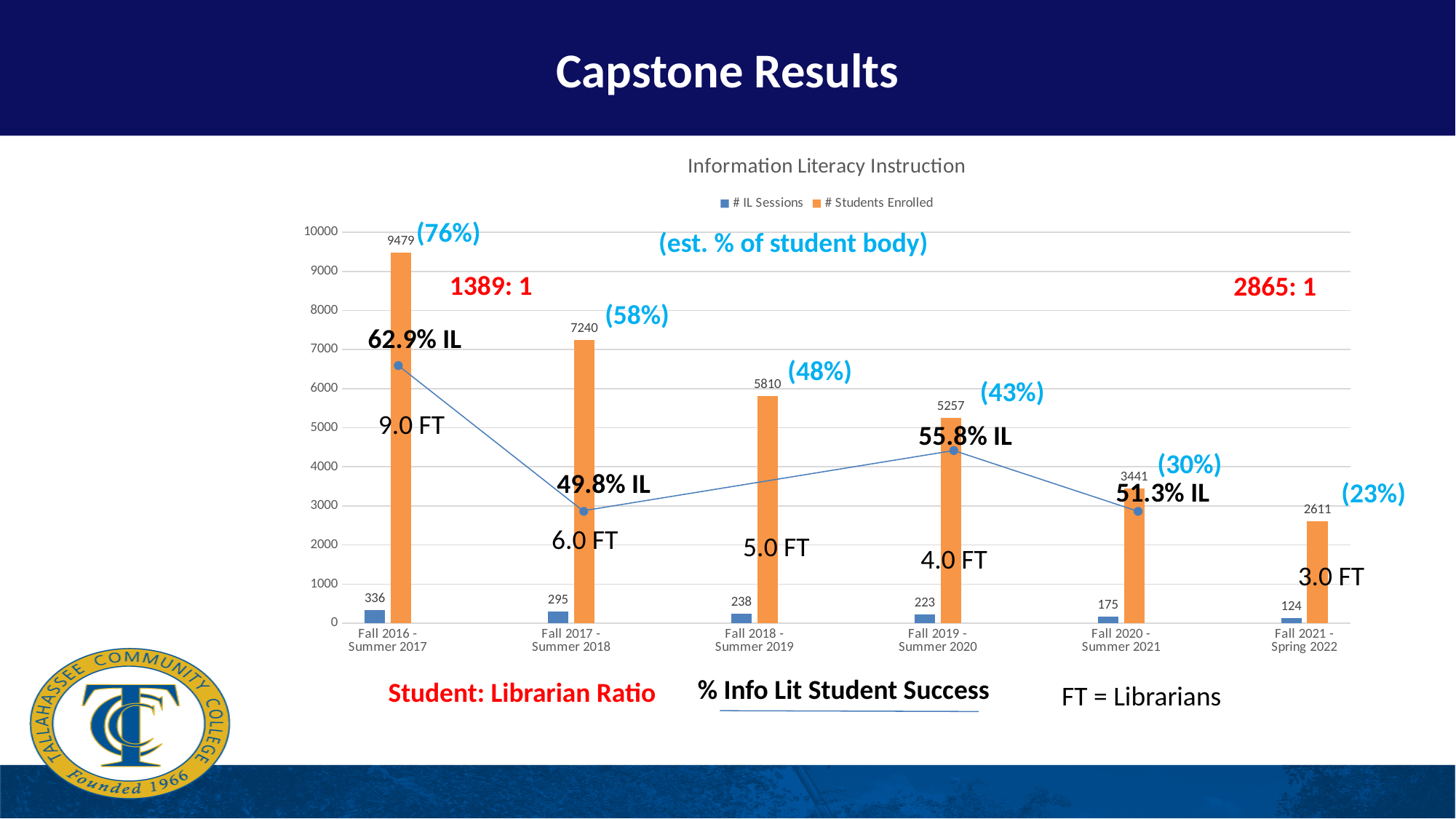
Do the # Students Enrolled values rise or fall across the periods from left to right? fall Which period has the lowest # IL Sessions? Fall 2021 - Spring 2022 Which is larger: # IL Sessions for Fall 2018 - Summer 2019 or for Fall 2019 - Summer 2020? Fall 2018 - Summer 2019 How many series does the chart legend list? 2 How many time periods are shown on the x axis of the chart? 6 What is the value of # IL Sessions for Fall 2020 - Summer 2021? 175 What is the title of the chart? Information Literacy Instruction Which period has the highest # Students Enrolled? Fall 2016 - Summer 2017 Is the value of # Students Enrolled for Fall 2019 - Summer 2020 greater or less than 5000? greater What is the value of # Students Enrolled for Fall 2021 - Spring 2022? 2611 What is the value of # Students Enrolled for Fall 2016 - Summer 2017? 9479 What is the difference in # Students Enrolled between Fall 2017 - Summer 2018 and Fall 2018 - Summer 2019? 1430